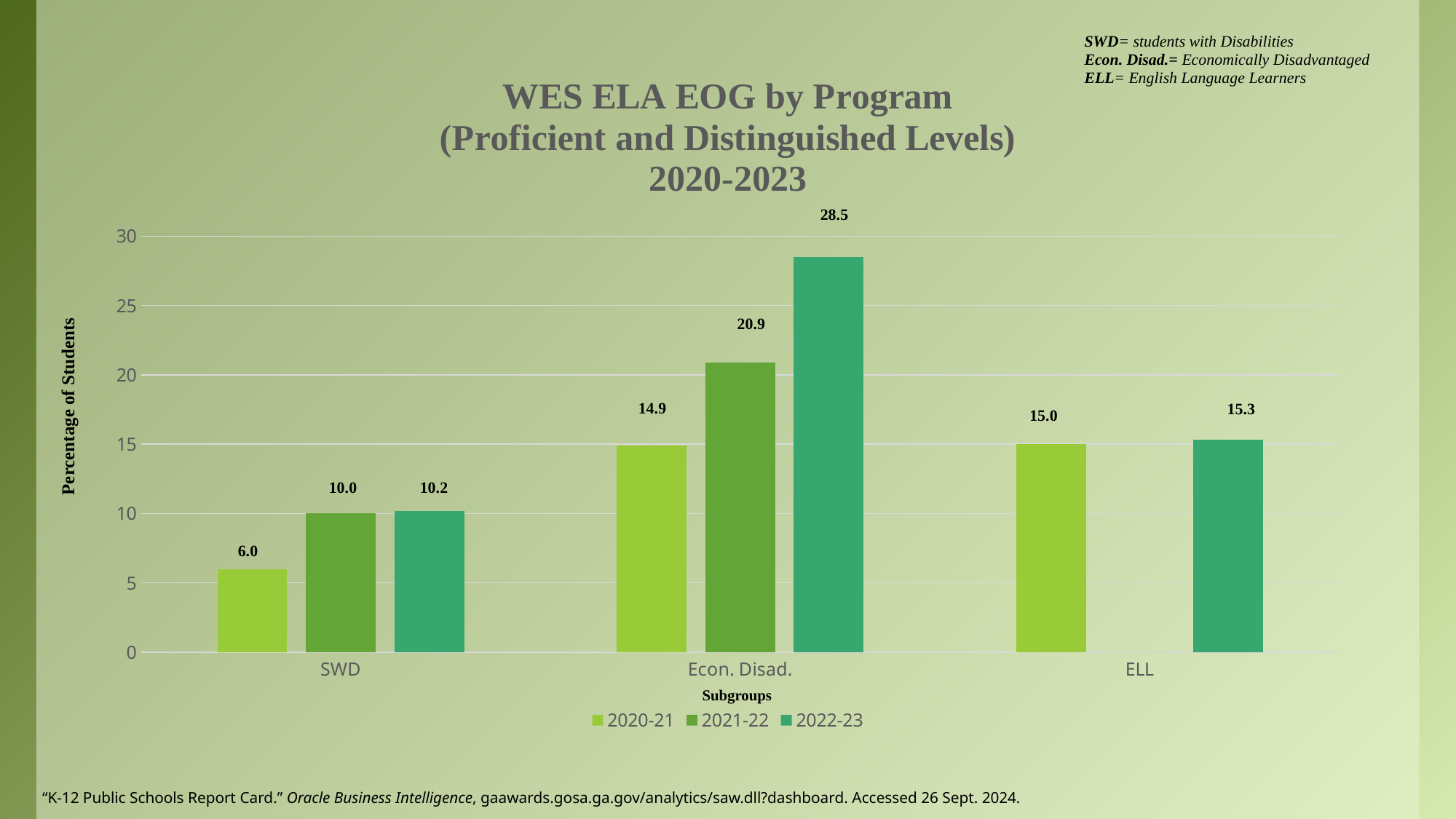
What is the label of the y axis? Percentage of Students What is the value for ELL in 2020-21? 15.0 How many series does the legend list? 3 Which is larger: the 2022-23 value for ELL or the 2022-23 value for SWD? ELL Which subgroup has the highest value in 2021-22? Econ. Disad. Is the value for Econ. Disad. in 2021-22 greater or less than 20? greater How many subgroups are shown on the x axis? 3 Which subgroup has the lowest value in 2022-23? SWD What is the value for SWD in 2020-21? 6.0 What is the difference between the 2022-23 and 2020-21 values for Econ. Disad.? 13.6 What is the value for Econ. Disad. in 2022-23? 28.5 What kind of chart is shown on the slide? bar chart